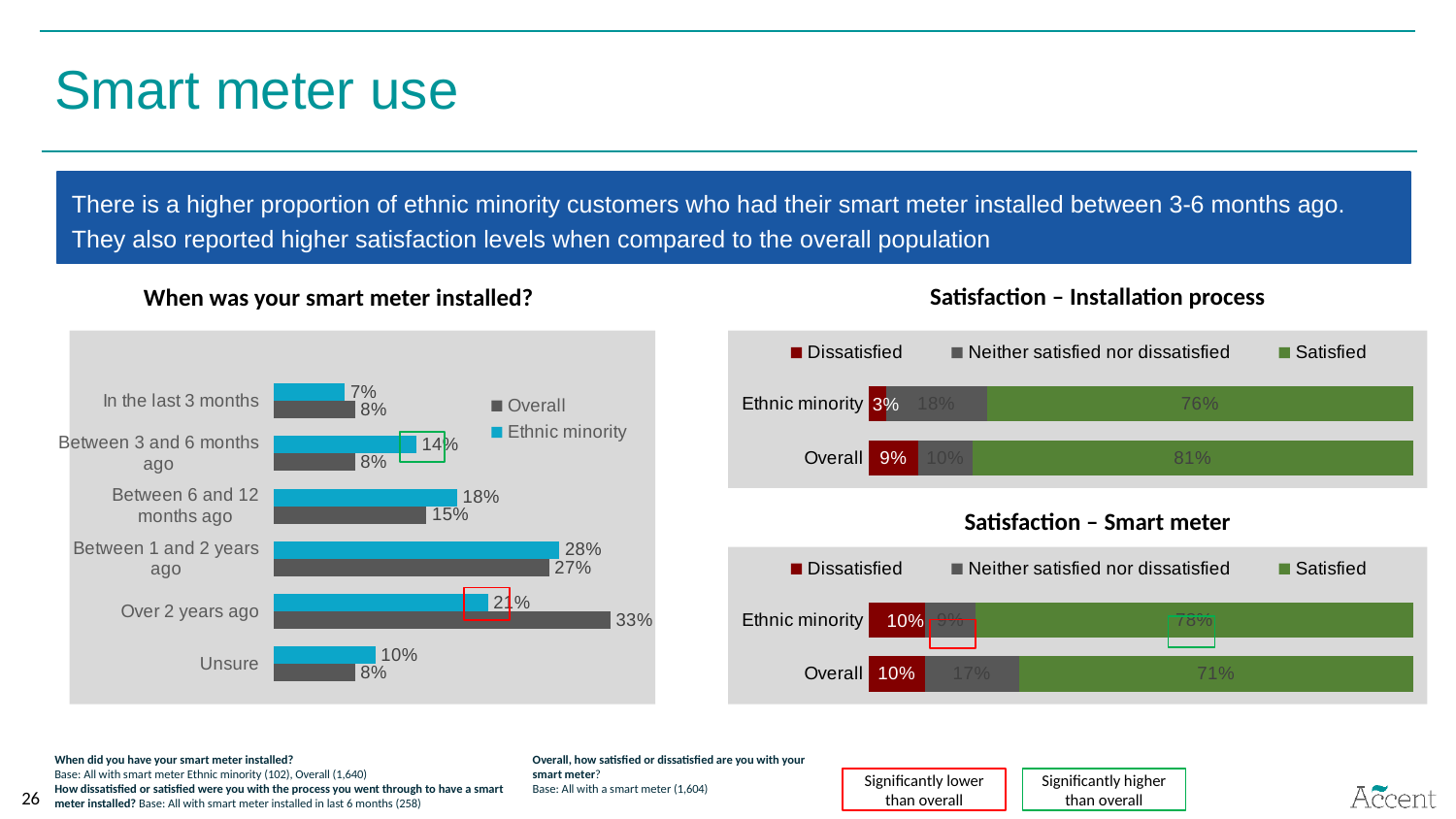
In the 'Satisfaction – Smart meter' chart, what percentage of Overall respondents are Neither satisfied nor dissatisfied? 17% In the 'Satisfaction – Installation process' chart, what is the difference between the Overall and Ethnic minority Dissatisfied values? 6% In the 'When was your smart meter installed?' chart, which is larger for 'Between 6 and 12 months ago': the Overall value or the Ethnic minority value? Ethnic minority How many categories are shown in the 'When was your smart meter installed?' chart? 6 How many series does the legend of the 'When was your smart meter installed?' chart list? 2 In the 'When was your smart meter installed?' chart, what is the Ethnic minority value for 'Between 3 and 6 months ago'? 14% In the 'When was your smart meter installed?' chart, what is the difference between the Overall and Ethnic minority values for 'Over 2 years ago'? 12% In the 'When was your smart meter installed?' chart, what is the Overall value for 'Over 2 years ago'? 33% In the 'When was your smart meter installed?' chart, which category has the highest Overall value? Over 2 years ago In the 'Satisfaction – Installation process' chart, what percentage of Ethnic minority respondents are Satisfied? 76% What type of chart is 'When was your smart meter installed?'? Bar chart In the 'When was your smart meter installed?' chart, which category has the lowest Ethnic minority value? In the last 3 months